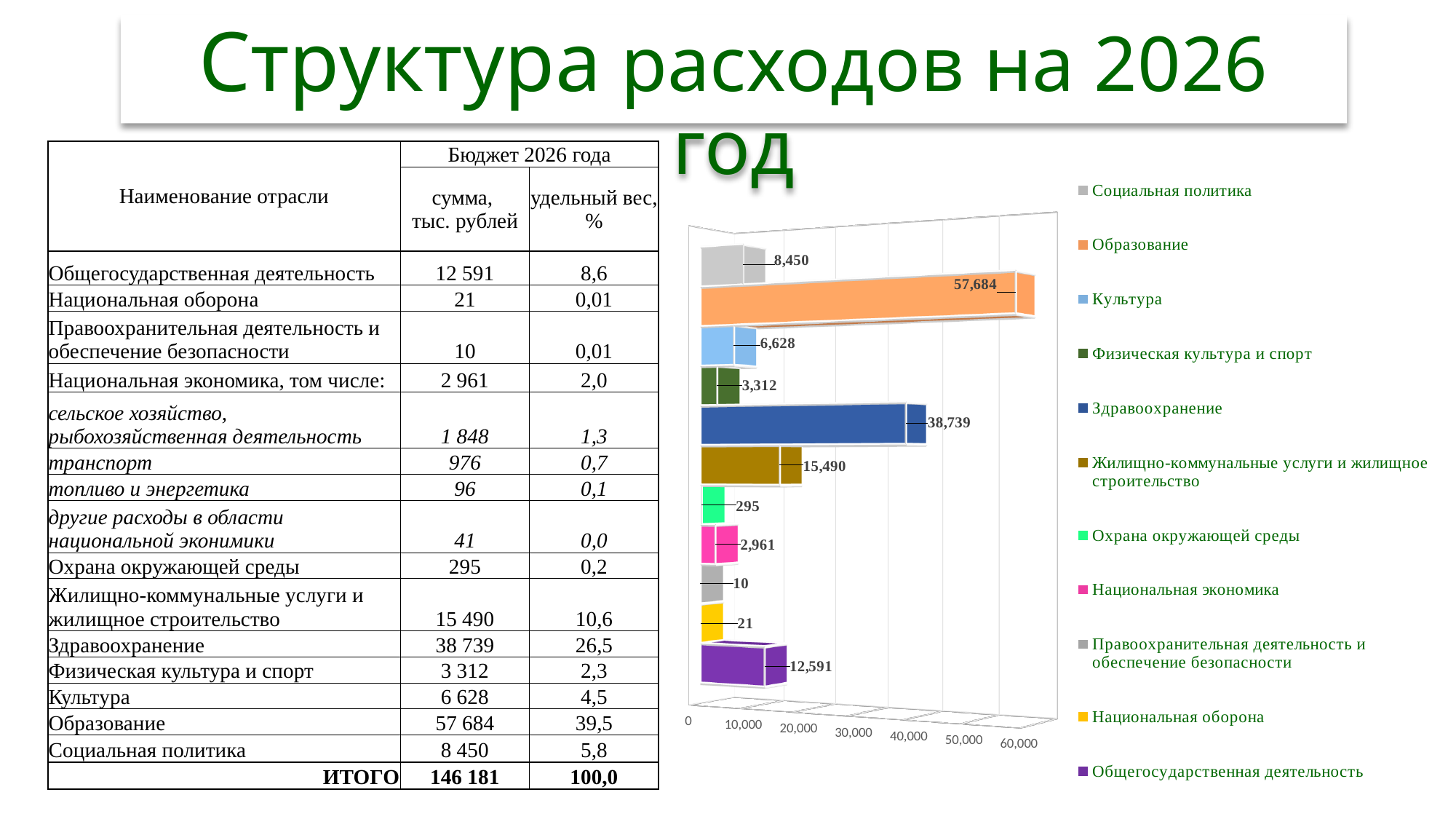
How many series does the legend of the bar chart list? 11 In the bar chart, is the value for Общегосударственная деятельность greater or less than 10,000? greater In the bar chart, what is the value for Здравоохранение? 38,739 In the bar chart, what is the value for Образование? 57,684 In the bar chart, which is larger: Культура or Социальная политика? Социальная политика In the bar chart, what is the difference between the values for Образование and Здравоохранение? 18,945 Which category has the highest value in the bar chart? Образование What type of chart is shown on the right side of the slide? bar chart In the bar chart, what is the value for Охрана окружающей среды? 295 In the bar chart, what is the value for Жилищно-коммунальные услуги и жилищное строительство? 15,490 Which category has the lowest value in the bar chart? Правоохранительная деятельность и обеспечение безопасности What colour is the bar for Образование in the chart? orange